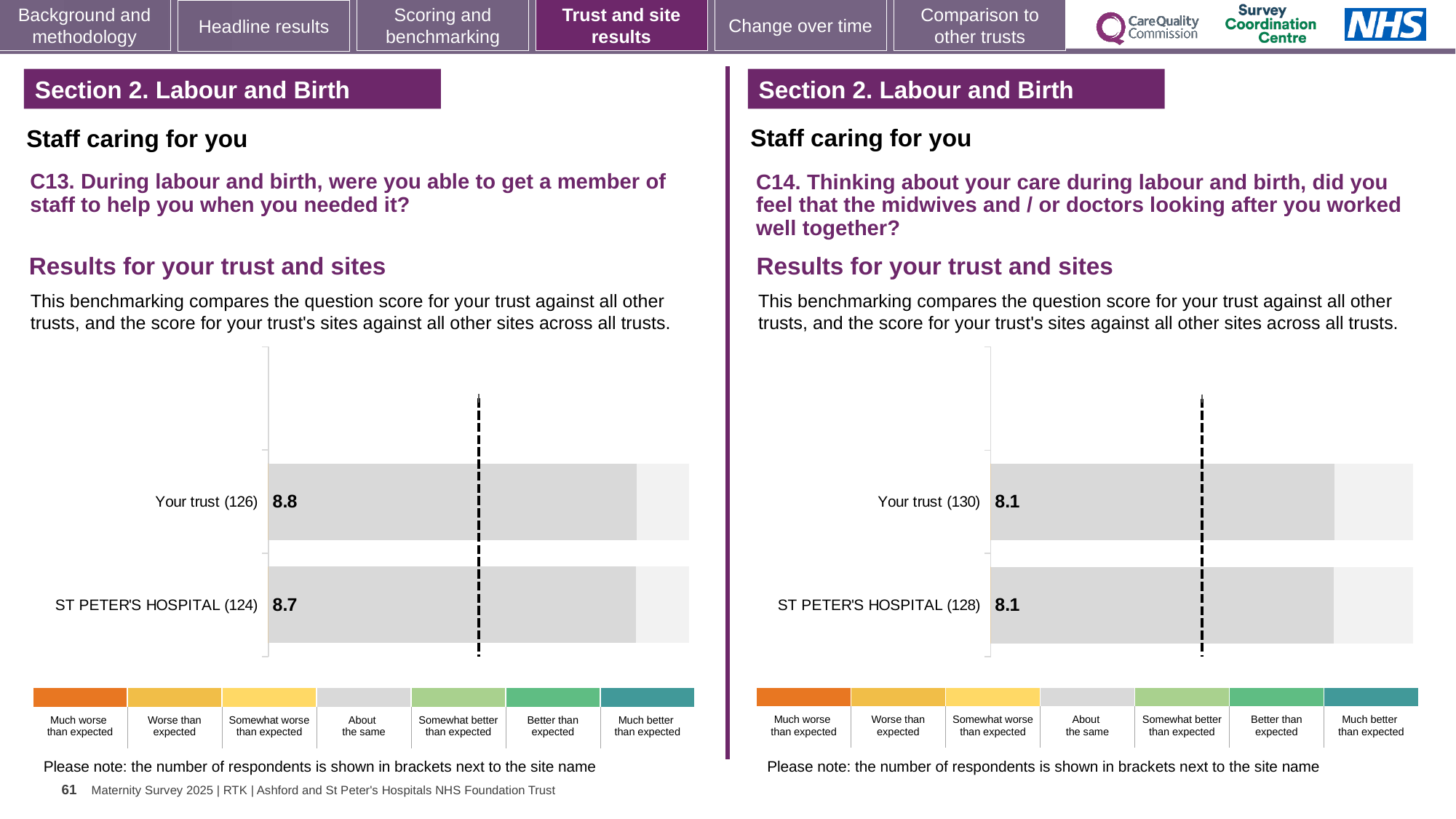
How many bars are plotted in the C14 chart on the right? 2 In the C13 chart on the left, which has the higher score, Your trust or ST PETER'S HOSPITAL? Your trust In the C13 chart on the left, what is the score for Your trust? 8.8 In the C13 chart on the left, how many respondents are shown in brackets for Your trust? 126 Is the Your trust score in the C13 chart on the left greater or less than the Your trust score in the C14 chart on the right? greater In the C13 chart on the left, what is the score for ST PETER'S HOSPITAL? 8.7 In the C14 chart on the right, how many respondents are shown in brackets for ST PETER'S HOSPITAL? 128 What kind of chart is the C13 chart on the left? Bar chart In the C13 chart on the left, what is the difference between the Your trust score and the ST PETER'S HOSPITAL score? 0.1 How many bars are plotted in the C13 chart on the left? 2 In the C14 chart on the right, what is the score for ST PETER'S HOSPITAL? 8.1 In the C14 chart on the right, what is the score for Your trust? 8.1